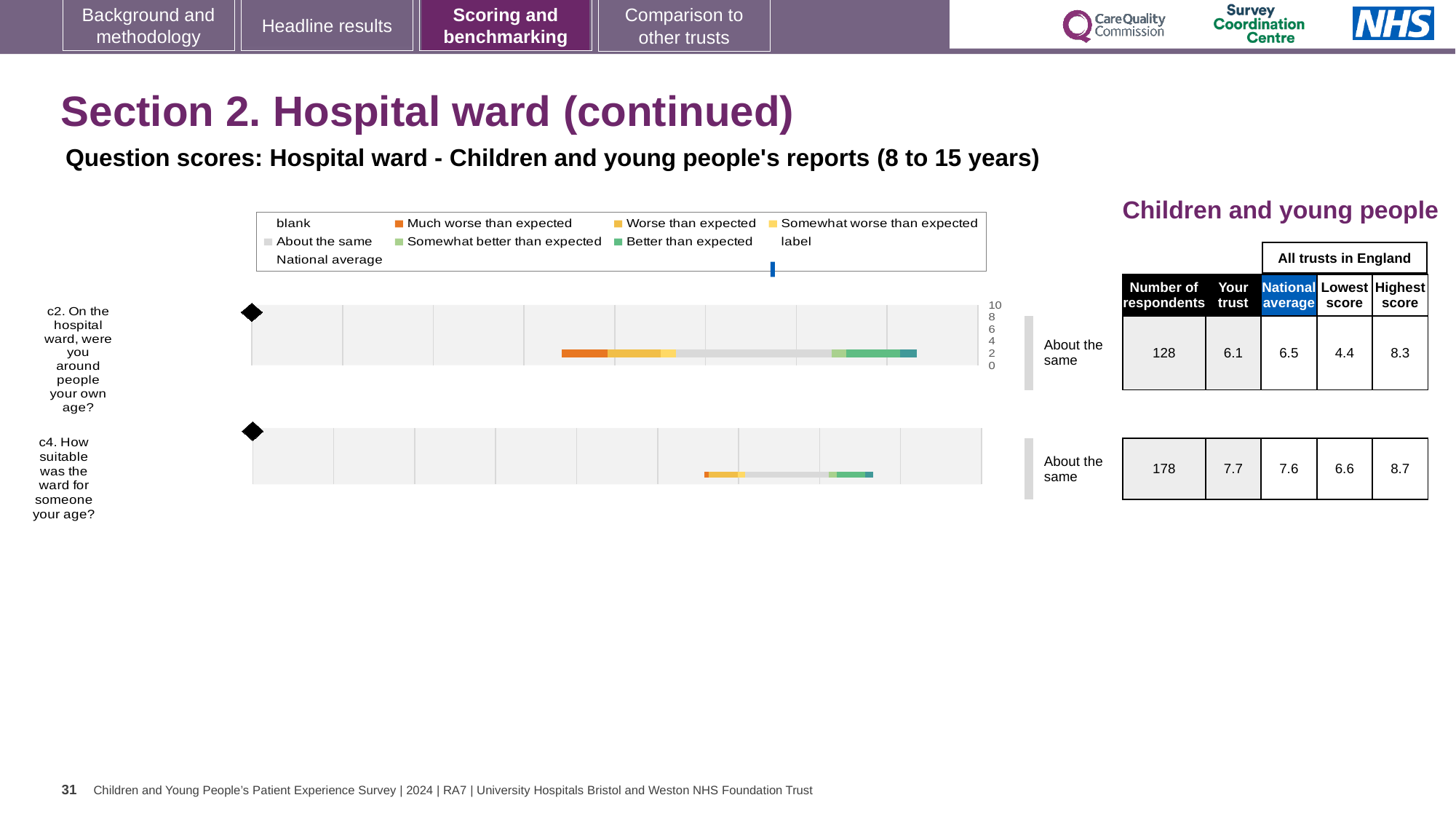
What is the difference between the 'Your trust' score and the national average for question c4? 0.1 What is the lowest score across all trusts in England for question c2? 4.4 What is the national average score for question c4 (How suitable was the ward for someone your age?)? 7.6 What is the 'Your trust' score for question c2 (On the hospital ward, were you around people your own age?)? 6.1 What is the highest score across all trusts in England for question c4? 8.7 How many questions are plotted in the chart on this slide? 2 What benchmark category is shown for question c2? About the same How many respondents answered question c2? 128 Which question has the higher 'Your trust' score, c2 or c4? c4 Which legend entry is represented by the dark orange colour in the chart? Much worse than expected What is the difference between the highest and lowest scores across all trusts for question c2? 3.9 What kind of chart is used to show the question scores on this slide? bar chart